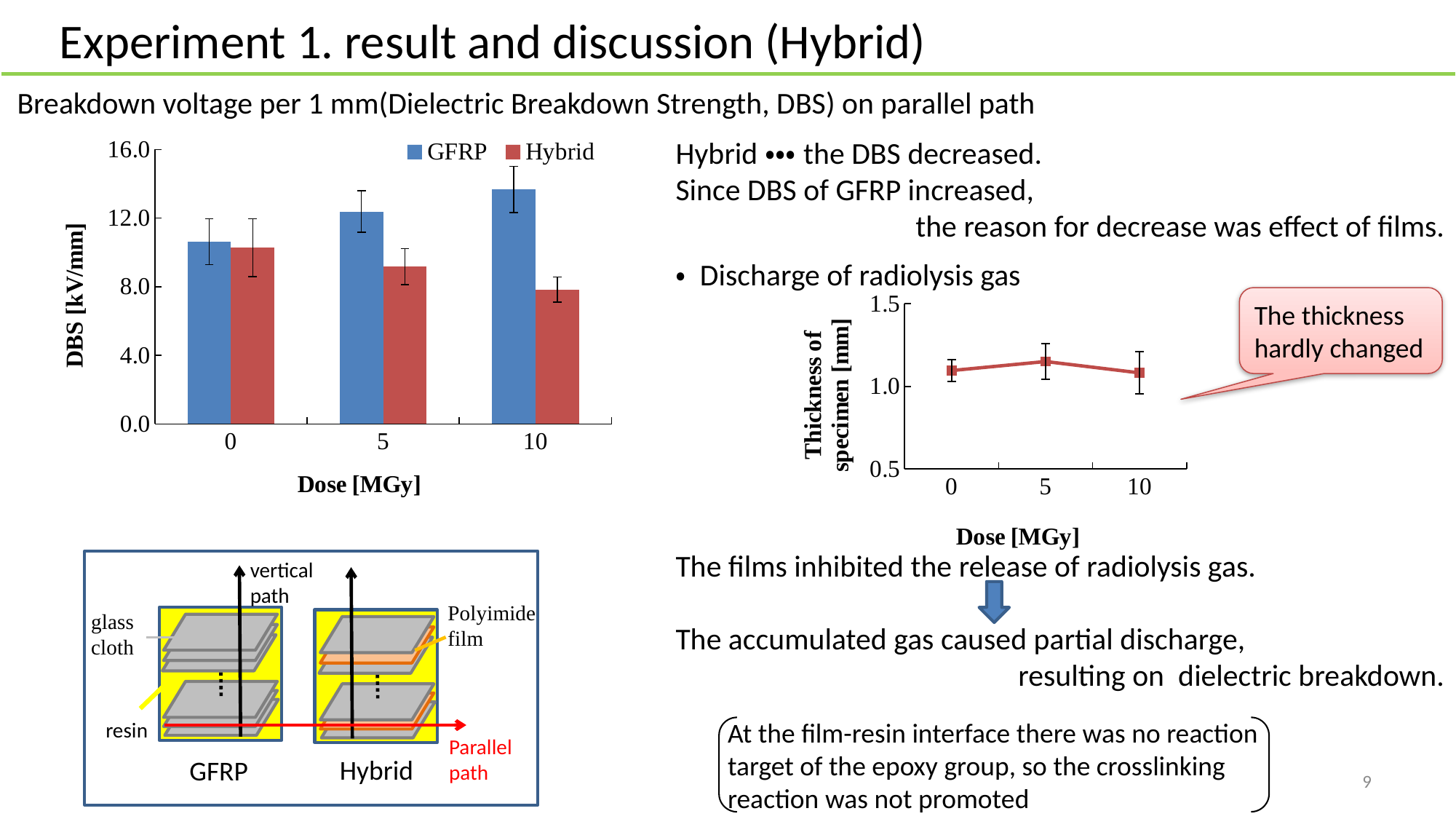
In the left bar chart, how many dose categories are shown on the x axis? 3 What kind of chart is the DBS versus Dose chart on the left of the slide? bar chart In the left bar chart, do the Hybrid values rise or fall as the dose increases? fall In the left bar chart, is the GFRP value at 10 MGy greater or less than 12.0? greater What kind of chart is the Thickness of specimen versus Dose chart on the right of the slide? line chart In the left bar chart, at a dose of 10 MGy, which series has the larger DBS, GFRP or Hybrid? GFRP In the left bar chart, at which dose is the GFRP value highest? 10 In the right line chart, is the thickness at 0 MGy greater or less than 1.0? greater In the left bar chart, what are the two series named in the legend? GFRP and Hybrid In the left bar chart, is the Hybrid value at 5 MGy greater or less than 8.0? greater In the left bar chart, at which dose is the Hybrid value lowest? 10 In the left bar chart, how many series does the legend list? 2